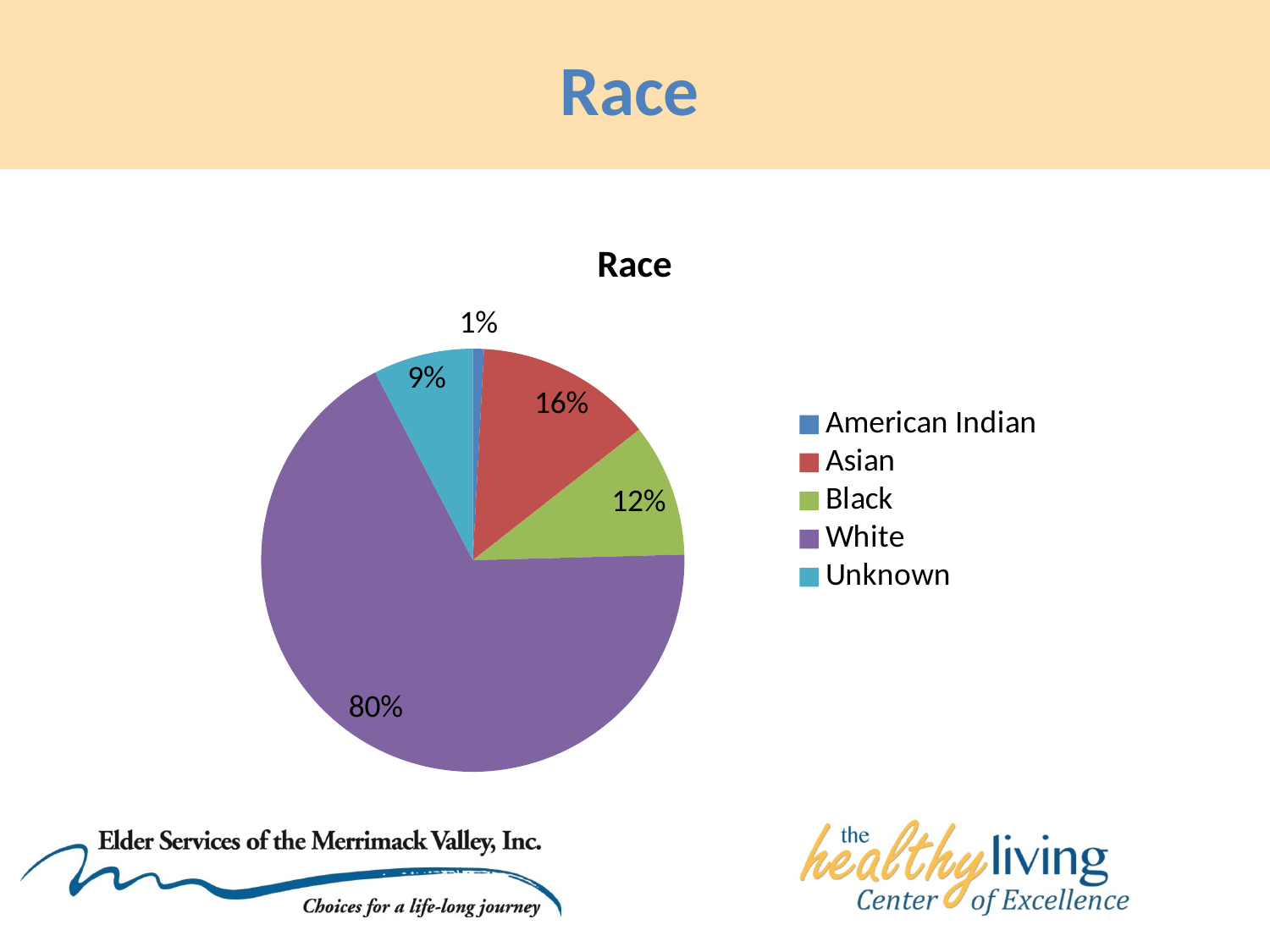
What is the difference in percentage points between the White share and the Asian share? 64 What percentage of the pie is Unknown? 9% Which category has the largest share of the pie? White What percentage of the pie is Black? 12% What percentage of the pie is White? 80% What kind of chart is shown on the slide? pie chart What is the title of the chart? Race What percentage of the pie is American Indian? 1% What percentage of the pie is Asian? 16% How many categories does the legend list? 5 Which category has the smallest share of the pie? American Indian Which is larger, the share for Asian or the share for Black? Asian